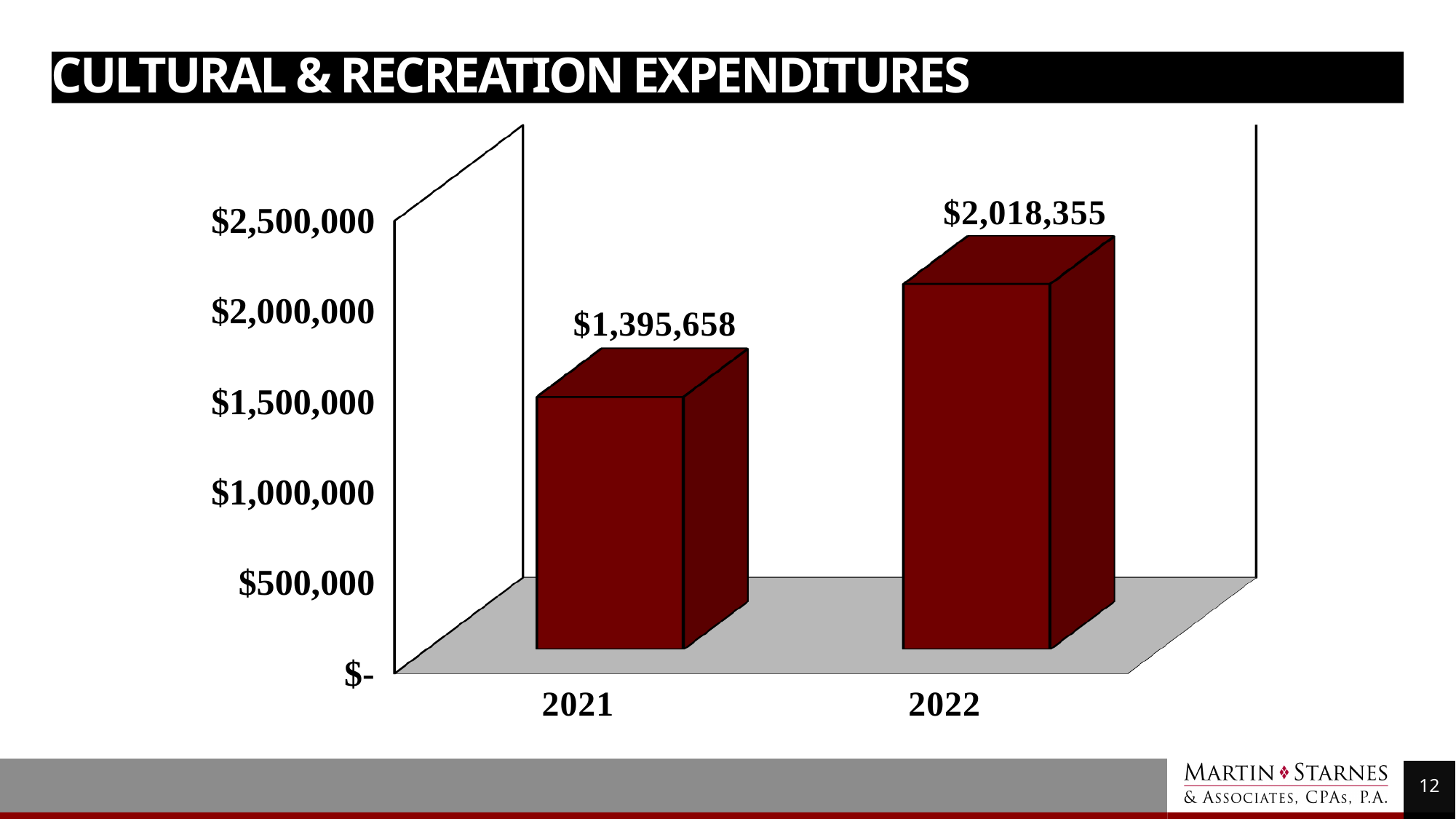
What is the difference between the 2022 and 2021 values? $622,697 Do the values rise or fall from 2021 to 2022? rise Which is larger, the value for 2021 or the value for 2022? 2022 Is the value for 2021 greater or less than $1,500,000? less How many years are shown on the chart? 2 What kind of chart is shown on the slide? bar chart What is the value for 2022? $2,018,355 What is the title of the slide? CULTURAL & RECREATION EXPENDITURES What is the value for 2021? $1,395,658 Which year has the highest expenditure? 2022 Is the value for 2022 greater or less than $2,000,000? greater Which year has the lowest expenditure? 2021